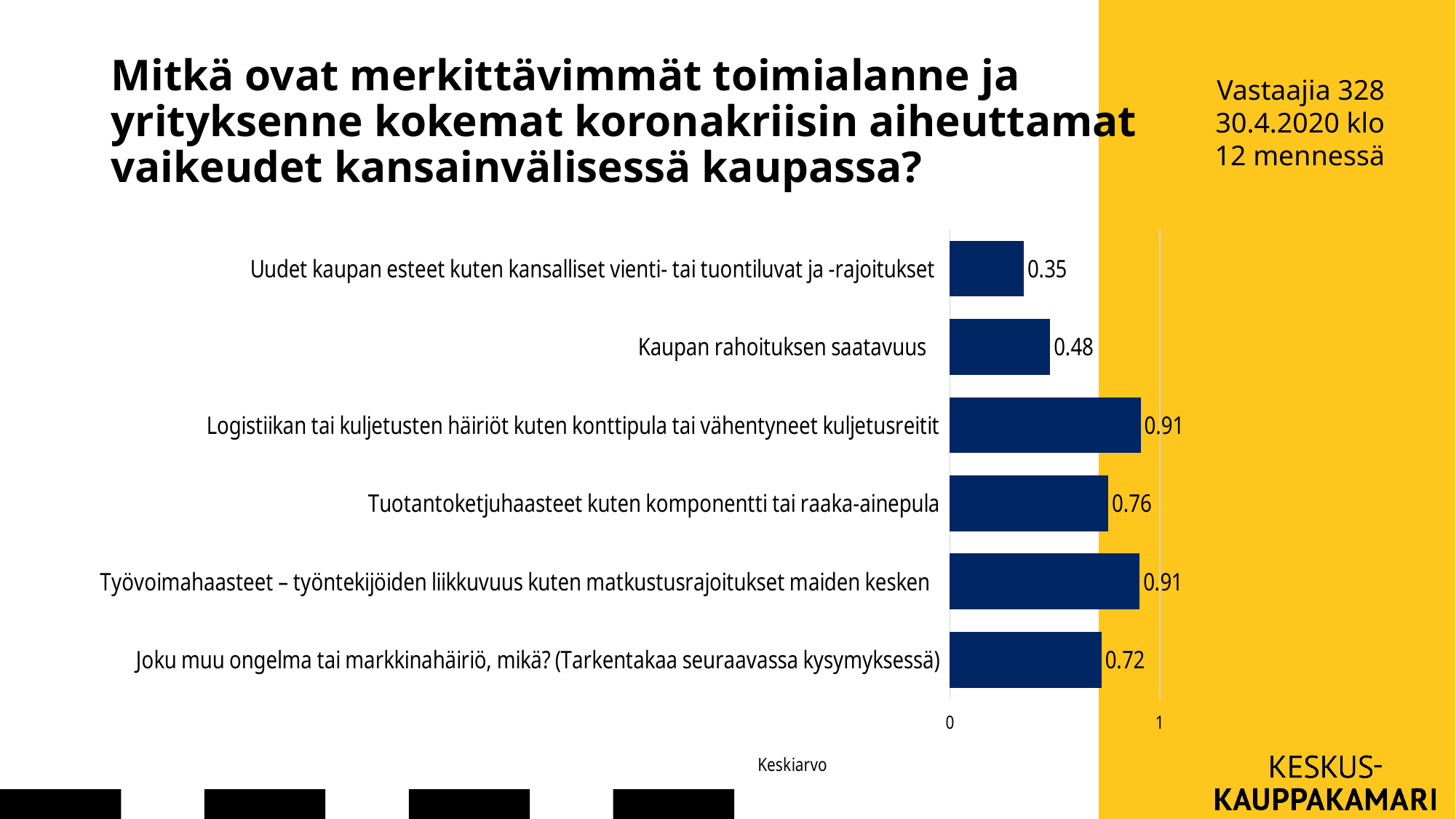
What is the difference between the values for "Logistiikan tai kuljetusten häiriöt kuten konttipula tai vähentyneet kuljetusreitit" and "Kaupan rahoituksen saatavuus"? 0.43 Which has a larger value, "Kaupan rahoituksen saatavuus" or "Tuotantoketjuhaasteet kuten komponentti tai raaka-ainepula"? Tuotantoketjuhaasteet kuten komponentti tai raaka-ainepula What is the value for "Joku muu ongelma tai markkinahäiriö, mikä? (Tarkentakaa seuraavassa kysymyksessä)"? 0.72 What is the value for "Uudet kaupan esteet kuten kansalliset vienti- tai tuontiluvat ja -rajoitukset"? 0.35 How many categories are shown in the chart? 6 What is the value for "Tuotantoketjuhaasteet kuten komponentti tai raaka-ainepula"? 0.76 What value does "Työvoimahaasteet – työntekijöiden liikkuvuus kuten matkustusrajoitukset maiden kesken" have? 0.91 What is the label shown below the x axis of the chart? Keskiarvo What is the difference between the values for "Tuotantoketjuhaasteet kuten komponentti tai raaka-ainepula" and "Joku muu ongelma tai markkinahäiriö, mikä? (Tarkentakaa seuraavassa kysymyksessä)"? 0.04 What is the value for "Kaupan rahoituksen saatavuus"? 0.48 Which category has the lowest value? Uudet kaupan esteet kuten kansalliset vienti- tai tuontiluvat ja -rajoitukset What kind of chart is shown on the slide? Bar chart